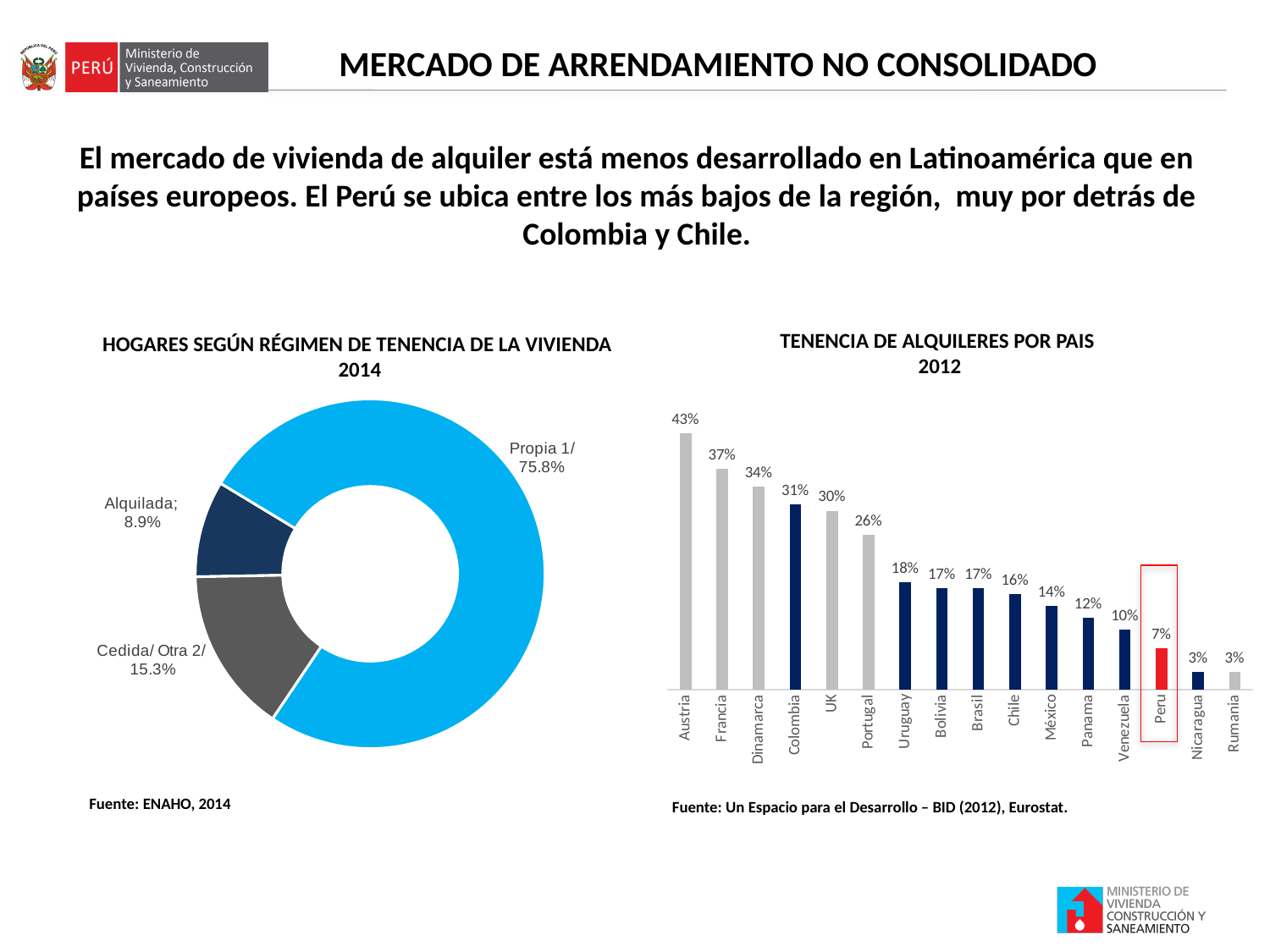
In the 'TENENCIA DE ALQUILERES POR PAIS 2012' chart, what is the value for Colombia? 31% In the 'TENENCIA DE ALQUILERES POR PAIS 2012' chart, which country has the highest value? Austria In the 'HOGARES SEGÚN RÉGIMEN DE TENENCIA DE LA VIVIENDA 2014' chart, what share is labelled for Propia 1/? 75.8% In the 'TENENCIA DE ALQUILERES POR PAIS 2012' chart, what is the difference between Chile and Peru? 9% What kind of chart is 'TENENCIA DE ALQUILERES POR PAIS 2012'? Bar chart What kind of chart is 'HOGARES SEGÚN RÉGIMEN DE TENENCIA DE LA VIVIENDA 2014'? Pie (doughnut) chart In the 'HOGARES SEGÚN RÉGIMEN DE TENENCIA DE LA VIVIENDA 2014' chart, what share is labelled for Alquilada? 8.9% In the 'HOGARES SEGÚN RÉGIMEN DE TENENCIA DE LA VIVIENDA 2014' chart, which category has the smallest share? Alquilada In the 'TENENCIA DE ALQUILERES POR PAIS 2012' chart, which is larger, Uruguay or México? Uruguay In the 'TENENCIA DE ALQUILERES POR PAIS 2012' chart, how many countries are shown? 16 In the 'HOGARES SEGÚN RÉGIMEN DE TENENCIA DE LA VIVIENDA 2014' chart, how many categories are shown? 3 In the 'TENENCIA DE ALQUILERES POR PAIS 2012' chart, what is the value for Peru? 7%